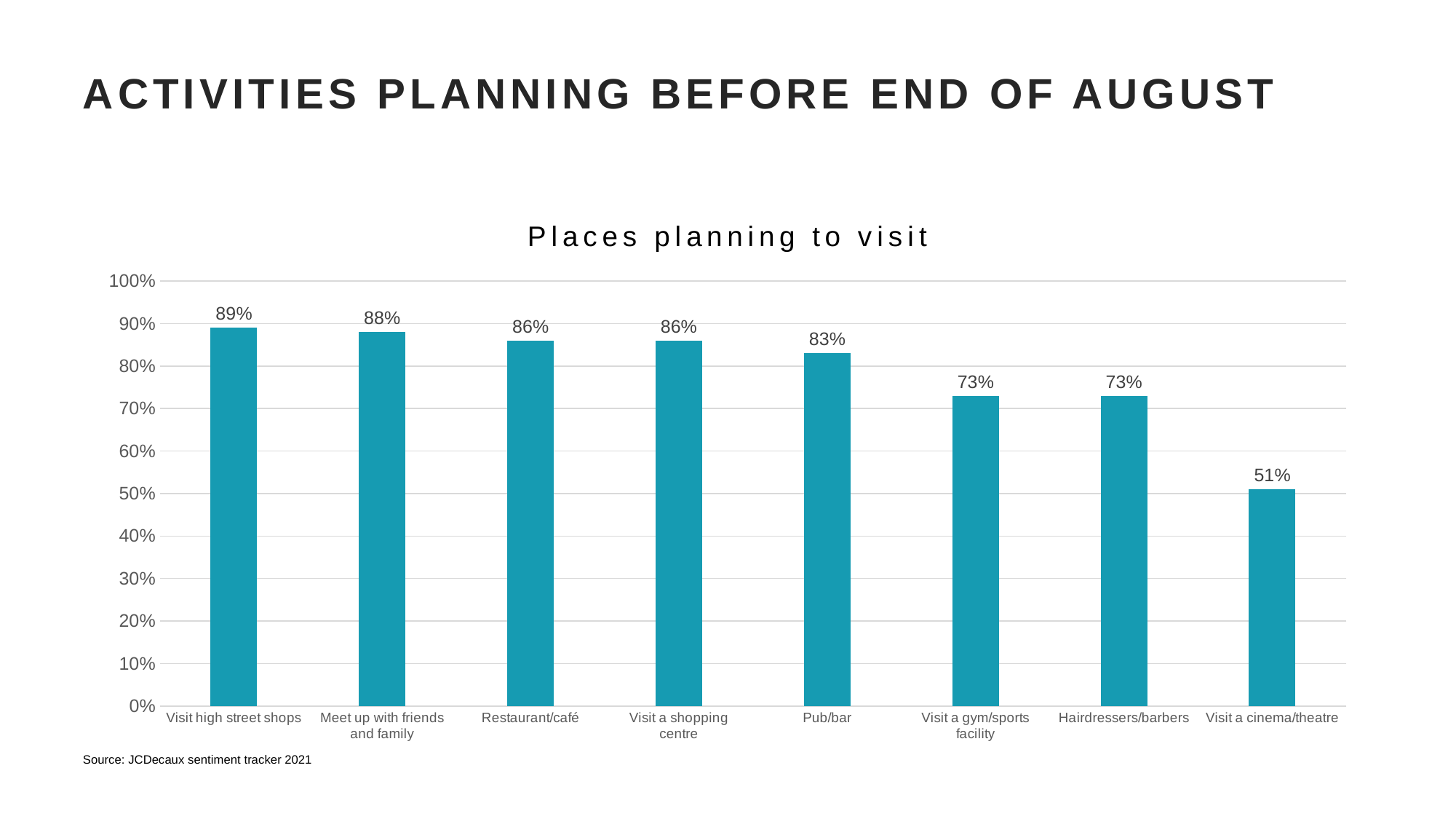
What is the difference between the values for Pub/bar and Visit a gym/sports facility? 10% What is the value for Hairdressers/barbers? 73% How many categories are shown on the chart? 8 Which is larger, the value for Meet up with friends and family or the value for Pub/bar? Meet up with friends and family What is the value for Pub/bar? 83% Which category has the highest value? Visit high street shops What is the difference between the values for Visit high street shops and Visit a cinema/theatre? 38% What kind of chart is shown on the slide? Bar chart What is the value for Visit high street shops? 89% What is the title of the chart? Places planning to visit What is the value for Visit a cinema/theatre? 51% Which category has the lowest value? Visit a cinema/theatre